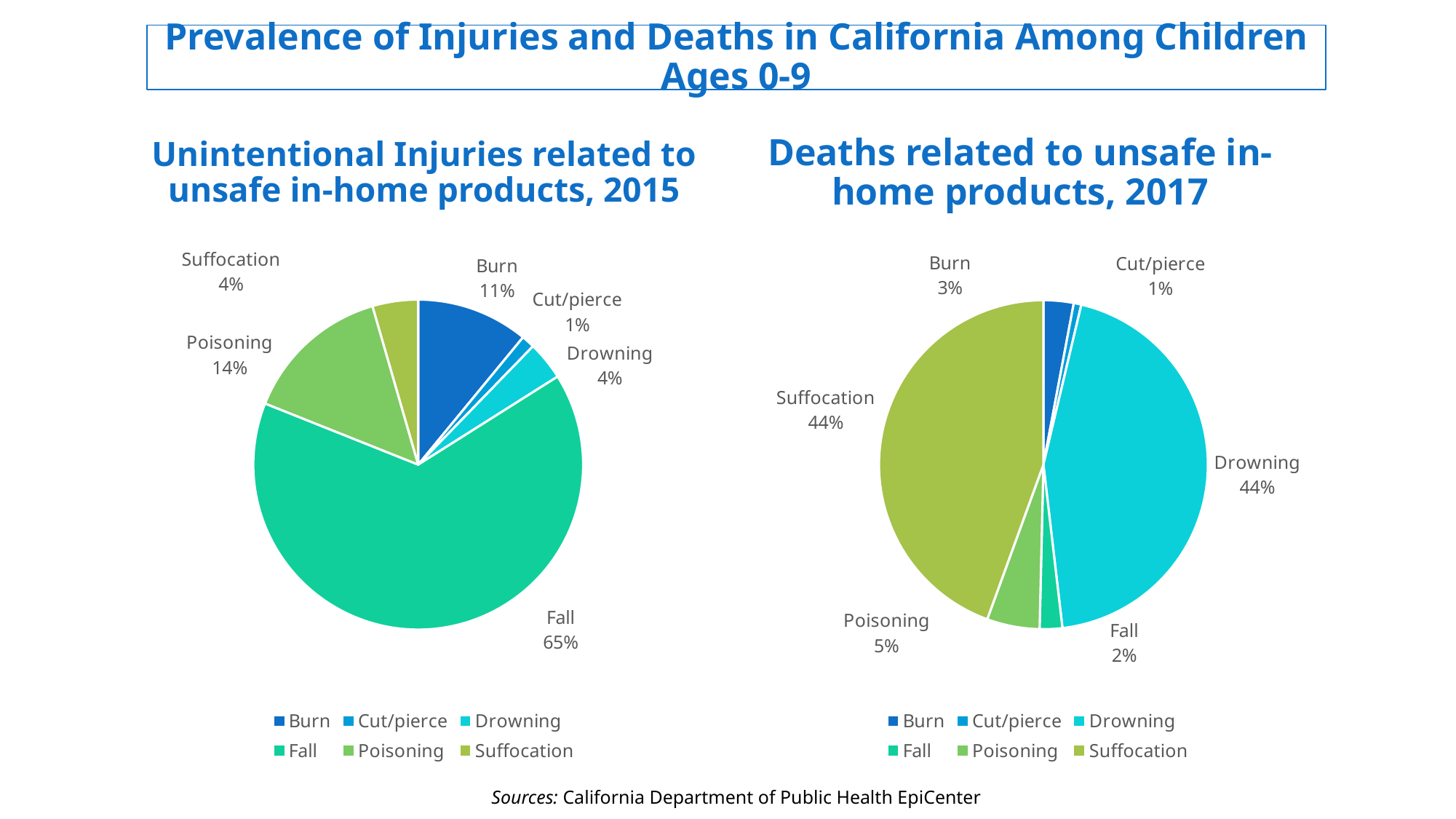
How many categories does the 'Deaths related to unsafe in-home products, 2017' chart show? 6 In the 'Deaths related to unsafe in-home products, 2017' chart, which category has the smallest share? Cut/pierce In the 'Unintentional Injuries related to unsafe in-home products, 2015' chart, what percentage is shown for Poisoning? 14% What kind of chart is the 'Unintentional Injuries related to unsafe in-home products, 2015' chart? Pie chart In the 'Deaths related to unsafe in-home products, 2017' chart, what percentage is shown for Suffocation? 44% What is the title of the chart on the right side of the slide? Deaths related to unsafe in-home products, 2017 In the 'Unintentional Injuries related to unsafe in-home products, 2015' chart, which category has the smallest share? Cut/pierce In the 'Unintentional Injuries related to unsafe in-home products, 2015' chart, what share of injuries is attributed to Fall? 65% In the 'Unintentional Injuries related to unsafe in-home products, 2015' chart, which category has the largest share? Fall In the 'Deaths related to unsafe in-home products, 2017' chart, which is larger, Poisoning or Burn? Poisoning In the 'Deaths related to unsafe in-home products, 2017' chart, what percentage is shown for Fall? 2% In the 'Unintentional Injuries related to unsafe in-home products, 2015' chart, what is the difference in percentage points between Fall and Poisoning? 51